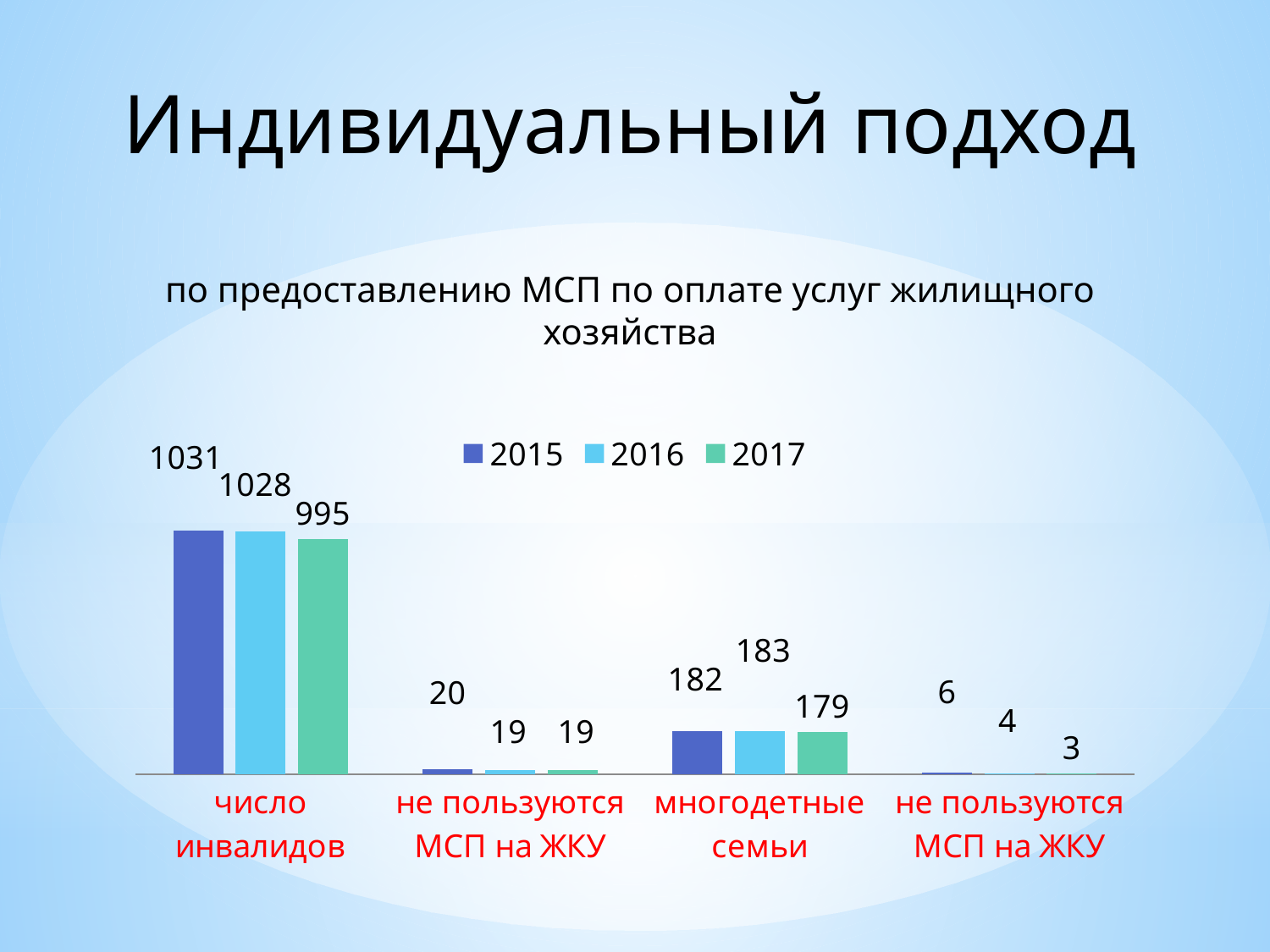
What is the value for 2016 in the "многодетные семьи" category? 183 What is the value for 2017 in the rightmost category ("не пользуются МСП на ЖКУ", next to "многодетные семьи")? 3 What is the value for 2017 in the "число инвалидов" category? 995 Which category has the highest values across all three years? число инвалидов What is the difference between the 2016 and 2017 values for "многодетные семьи"? 4 What is the value for 2015 in the "число инвалидов" category? 1031 What is the difference between the 2015 and 2017 values for "число инвалидов"? 36 How many series does the legend list? 3 Which is larger for "многодетные семьи": the 2015 value or the 2017 value? 2015 What kind of chart is shown on the slide? bar chart Do the values for "число инвалидов" rise or fall from 2015 to 2017? fall What is the value for 2015 in the second category from the left ("не пользуются МСП на ЖКУ", next to "число инвалидов")? 20